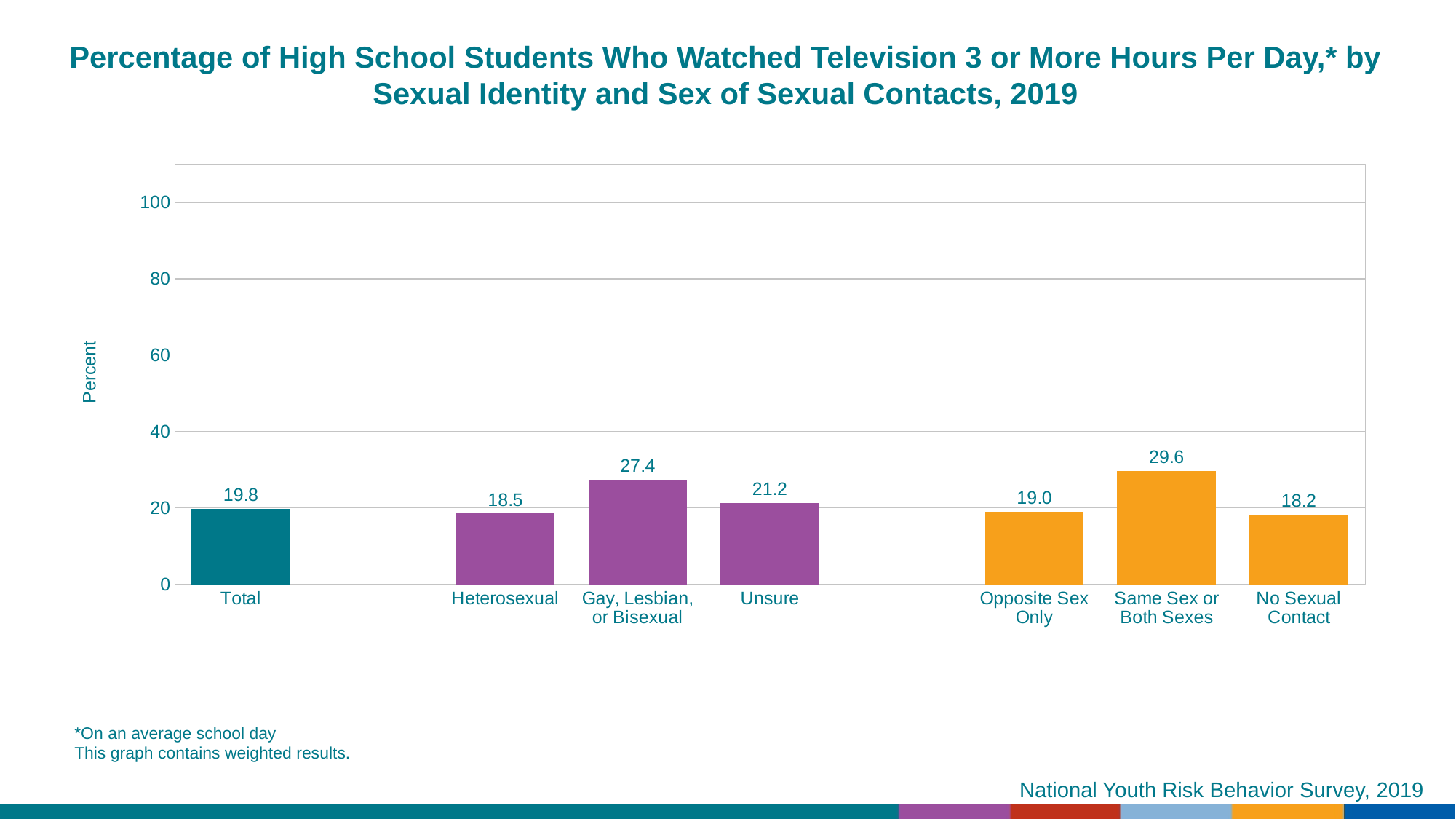
What is the value for Total? 19.8 Which category has the lowest value? No Sexual Contact Which is larger, the value for Unsure or the value for Opposite Sex Only? Unsure What is the value for No Sexual Contact? 18.2 How many categories are shown on the chart? 7 What is the value for Same Sex or Both Sexes? 29.6 What kind of chart is this? bar chart What is the value for Gay, Lesbian, or Bisexual students? 27.4 Is the value for Same Sex or Both Sexes greater or less than 40? less Which category has the highest value? Same Sex or Both Sexes What is the label on the vertical axis? Percent What is the difference between the values for Gay, Lesbian, or Bisexual and Heterosexual? 8.9